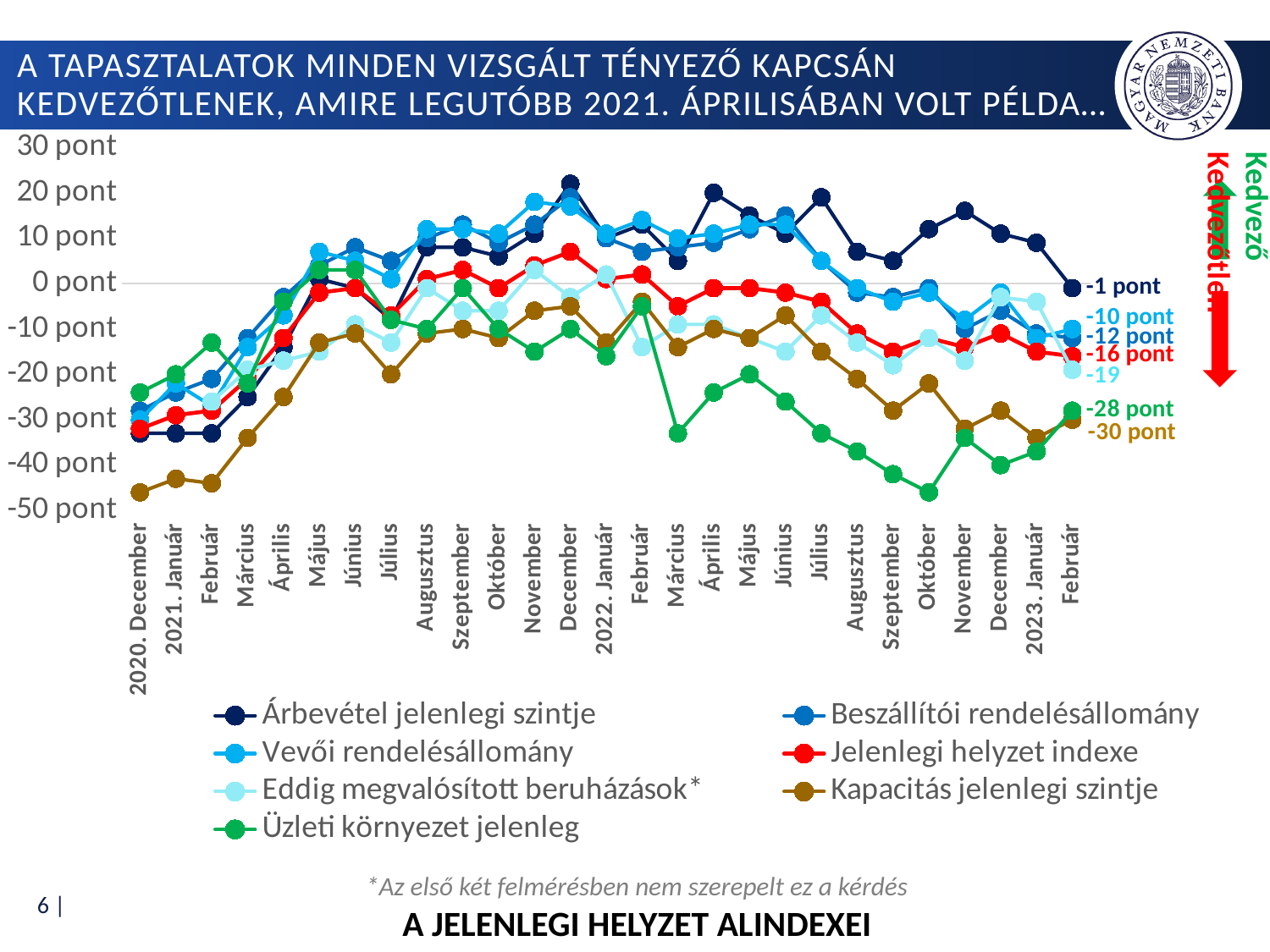
Which series has the highest value in 2023 Február? Árbevétel jelenlegi szintje How many series does the legend list? 7 What is the value of Árbevétel jelenlegi szintje in 2023 Február? -1 pont What is the value of Jelenlegi helyzet indexe in 2023 Február? -16 pont What is the value of Kapacitás jelenlegi szintje in 2023 Február? -30 pont How many months are shown on the x axis? 27 In 2023 Február, which is larger: Vevői rendelésállomány or Beszállítói rendelésállomány? Vevői rendelésállomány Which series has the lowest value in 2023 Február? Kapacitás jelenlegi szintje Is the value for Kapacitás jelenlegi szintje in 2020 December greater or less than -40 pont? less What kind of chart is shown on the slide? line chart What is the difference between Árbevétel jelenlegi szintje and Kapacitás jelenlegi szintje in 2023 Február? 29 pont What is the title printed below the chart? A JELENLEGI HELYZET ALINDEXEI